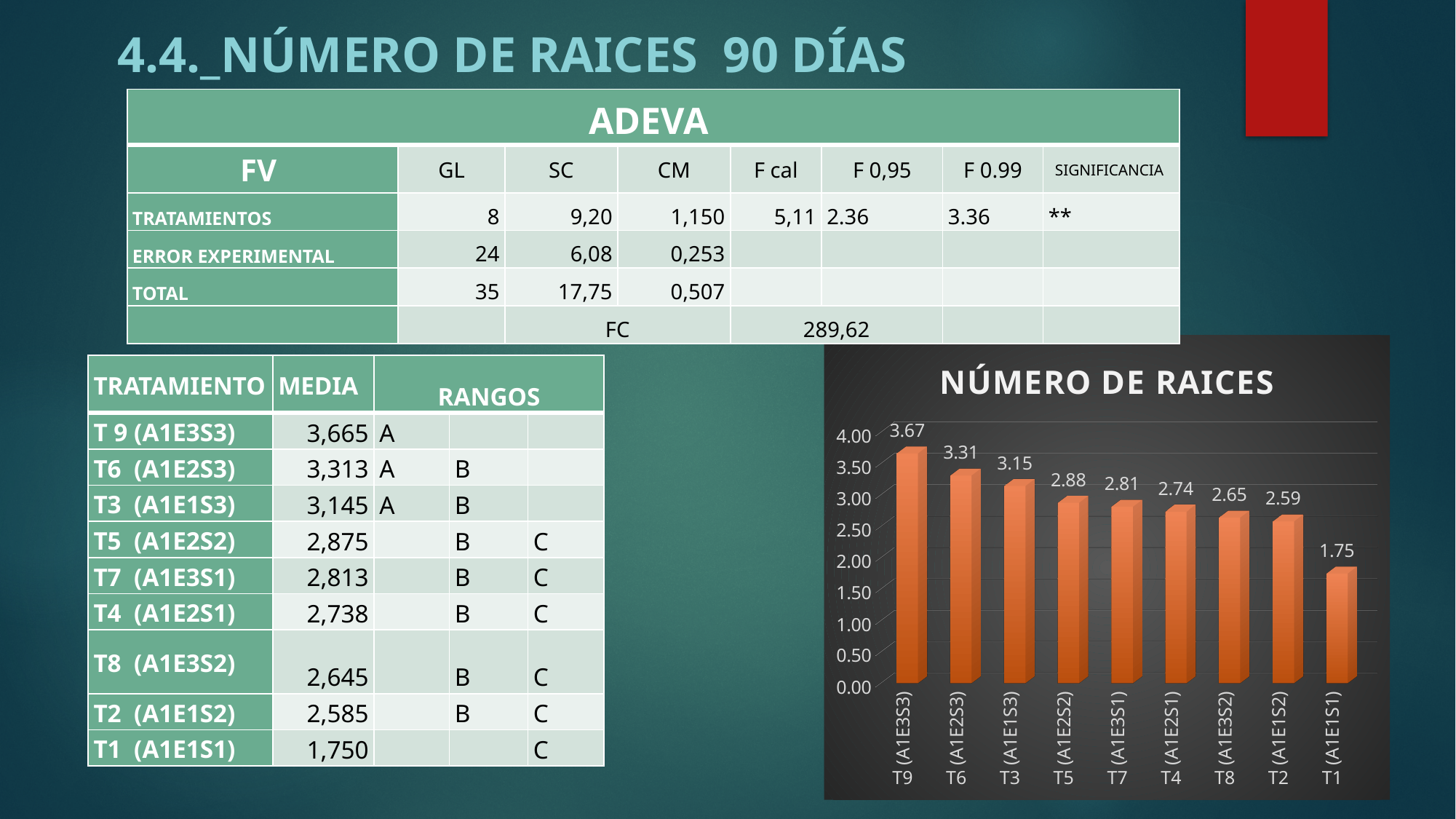
What kind of chart is the NÚMERO DE RAICES chart? bar chart Which has a larger value in the NÚMERO DE RAICES chart, T7 (A1E3S1) or T2 (A1E1S2)? T7 (A1E3S1) What is the value for T9 (A1E3S3) in the NÚMERO DE RAICES chart? 3.67 What is the difference between the values for T6 (A1E2S3) and T3 (A1E1S3) in the NÚMERO DE RAICES chart? 0.16 What is the value for T1 (A1E1S1) in the NÚMERO DE RAICES chart? 1.75 Do the values in the NÚMERO DE RAICES chart rise or fall from left to right along the x axis? fall What is the value for T5 (A1E2S2) in the NÚMERO DE RAICES chart? 2.88 How many treatments are shown in the NÚMERO DE RAICES chart? 9 What is the difference between the values for T9 (A1E3S3) and T1 (A1E1S1) in the NÚMERO DE RAICES chart? 1.92 Is the value for T8 (A1E3S2) in the NÚMERO DE RAICES chart greater or less than 3.00? less Which treatment has the highest value in the NÚMERO DE RAICES chart? T9 (A1E3S3) Which treatment has the lowest value in the NÚMERO DE RAICES chart? T1 (A1E1S1)